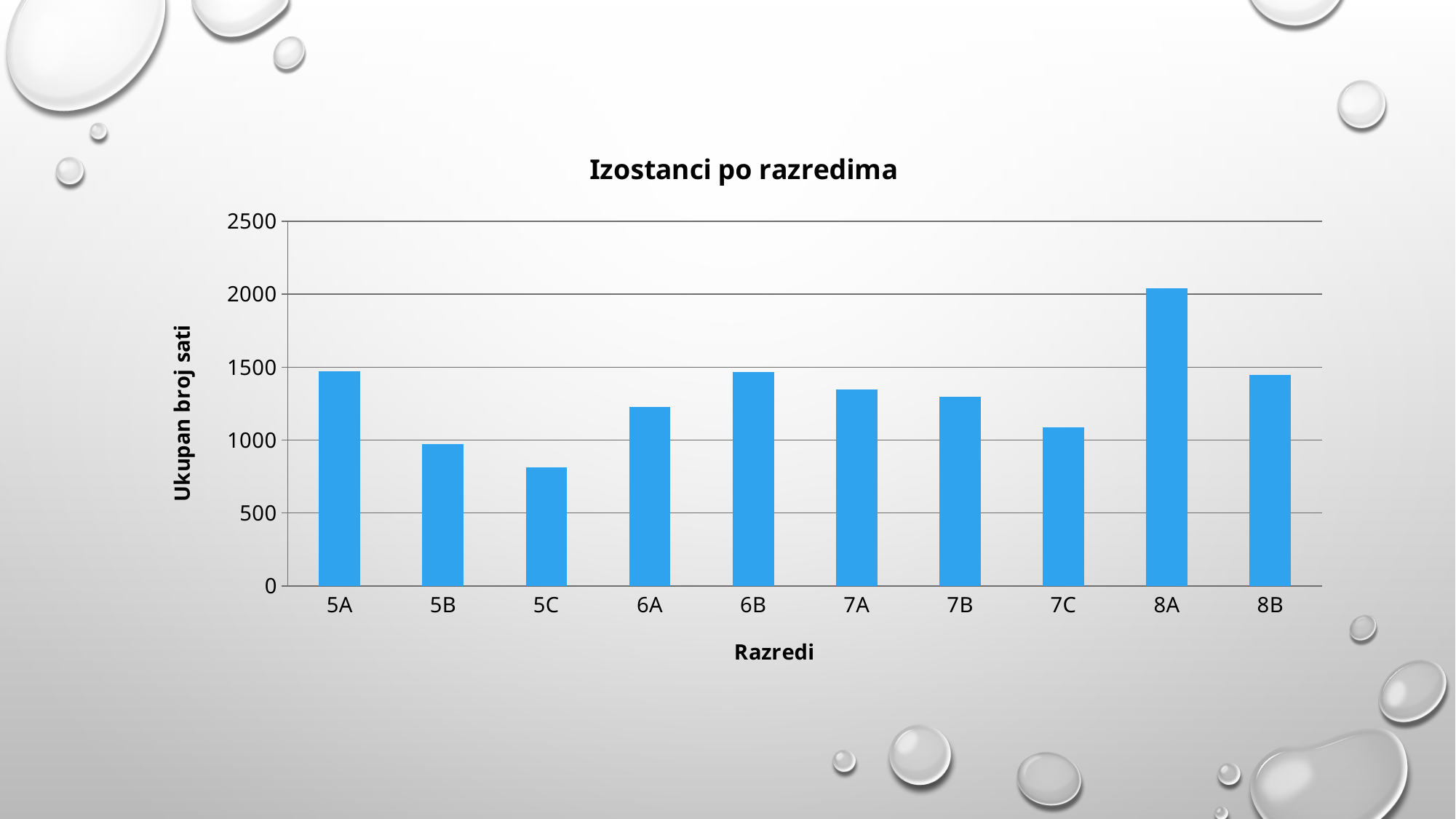
Is the value for 8A greater or less than 2000? greater What type of chart is shown on the slide? bar chart What is the title of the chart? Izostanci po razredima Is the value for 7A greater or less than 1500? less Which class has the lowest total number of hours? 5C What is the label of the vertical axis? Ukupan broj sati Which is larger, the value for 7C or the value for 8B? 8B Which class has the highest total number of hours? 8A Is the value for 7C greater or less than 1000? greater How many classes (categories) are shown on the x axis? 10 Which is larger, the value for 5A or the value for 5B? 5A